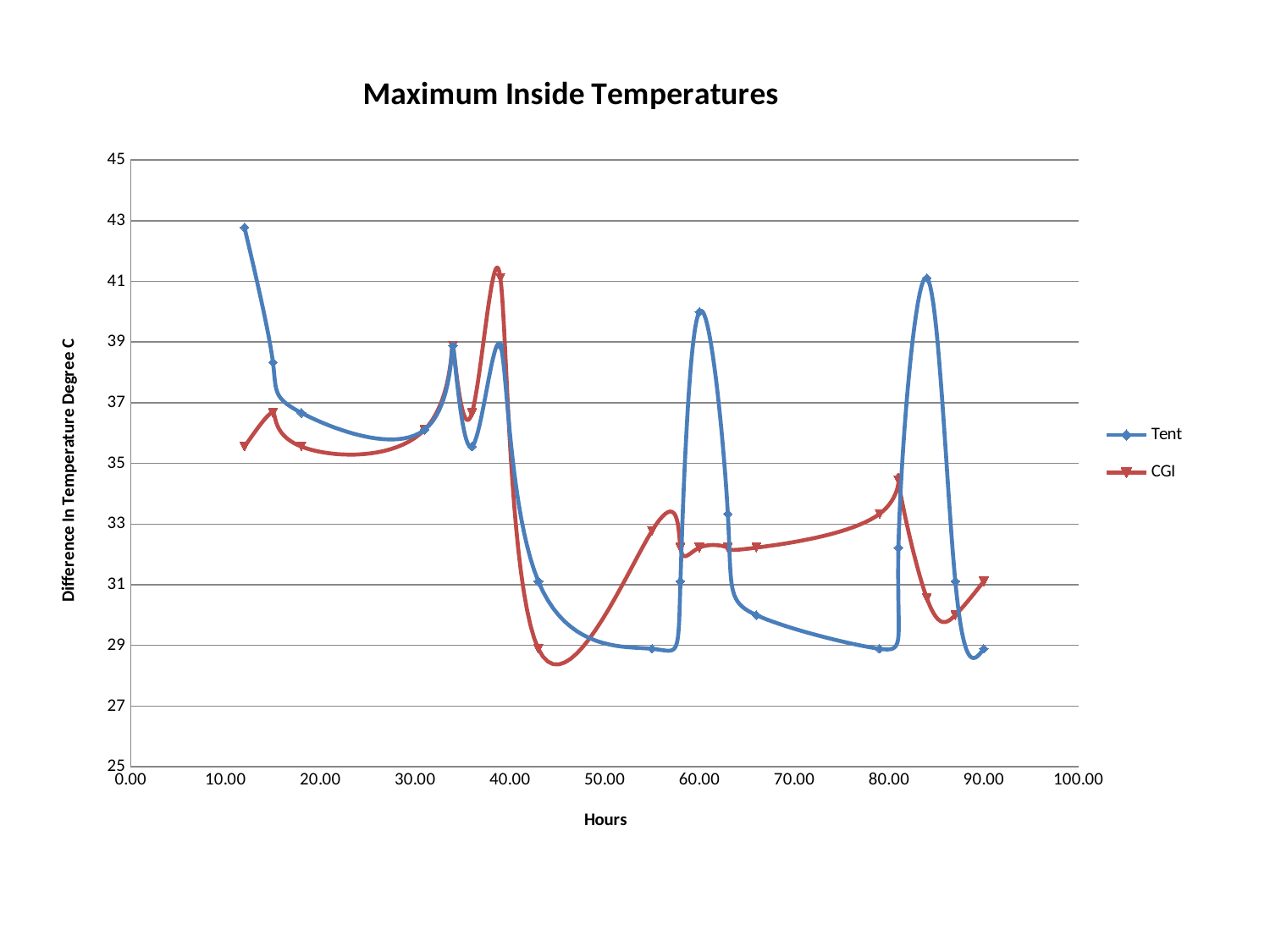
Is the Tent value at about 60 hours greater or less than 39? greater Is the CGI value at about 43 hours greater or less than 31? less What kind of chart is shown on the slide? line chart How many series does the legend list? 2 At about 60 hours, which series has the higher value, Tent or CGI? Tent Is the first Tent value (at about 12 hours) greater or less than 41? greater At about 81 hours, which series has the higher value, Tent or CGI? CGI Which series reaches the highest temperature anywhere on the chart? Tent Between about 12 and 30 hours, does the Tent series rise or fall? fall What is the label of the vertical axis? Difference In Temperature Degree C What is the title of the chart? Maximum Inside Temperatures Between about 66 and 81 hours, does the CGI series rise or fall? rise